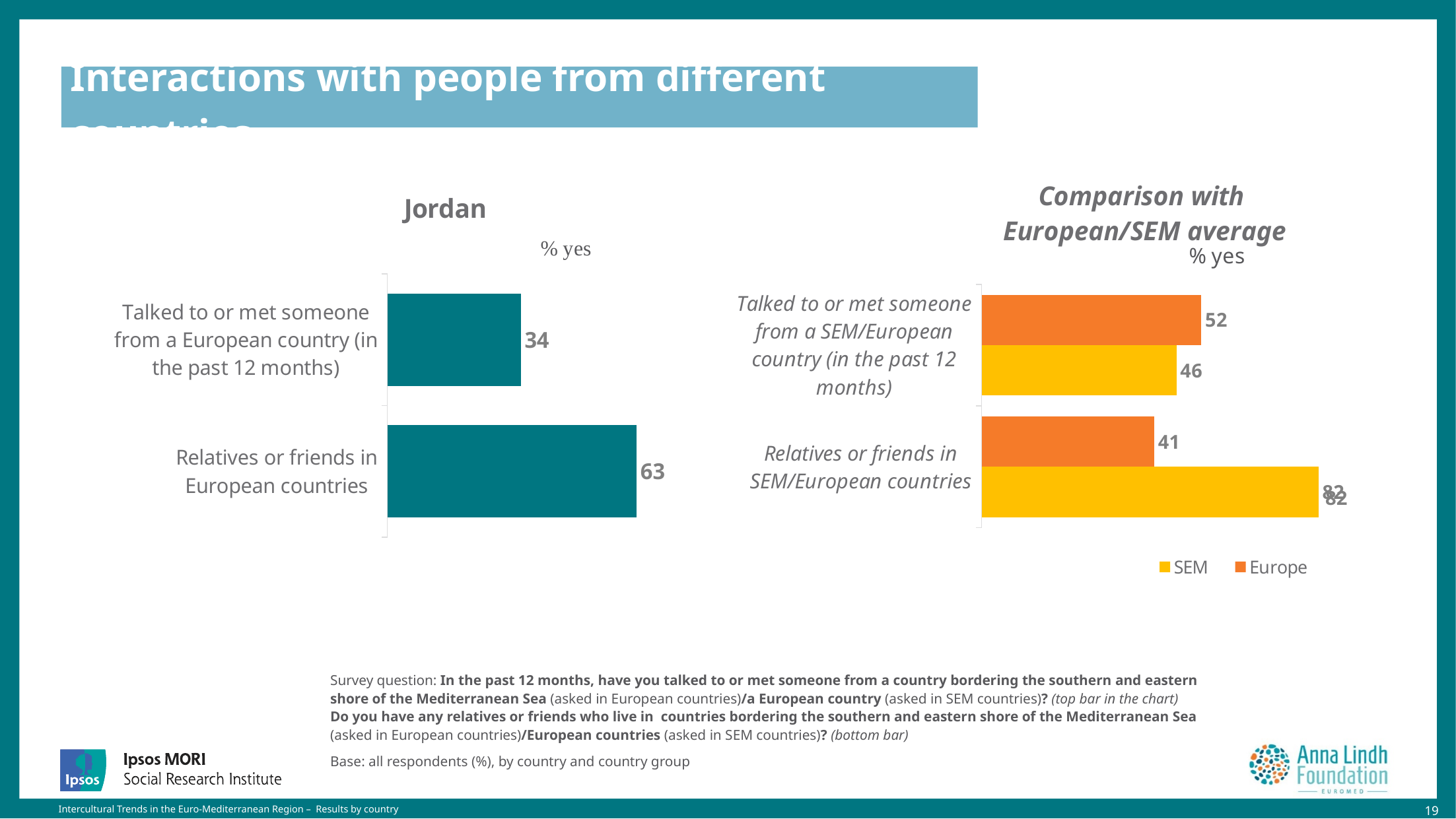
What kind of chart is the Jordan chart? Bar chart In the 'Comparison with European/SEM average' chart, what is the Europe value for 'Relatives or friends in SEM/European countries'? 41 In the 'Comparison with European/SEM average' chart, what is the difference between the Europe and SEM values for 'Talked to or met someone from a SEM/European country'? 6 In the Jordan chart, what is the value for 'Relatives or friends in European countries'? 63 How many series does the legend of the 'Comparison with European/SEM average' chart list? 2 In the Jordan chart, how many categories are plotted? 2 In the Jordan chart, what is the value for 'Talked to or met someone from a European country (in the past 12 months)'? 34 In the 'Comparison with European/SEM average' chart, what is the Europe value for 'Talked to or met someone from a SEM/European country (in the past 12 months)'? 52 In the Jordan chart, which category has the highest value? Relatives or friends in European countries In the 'Comparison with European/SEM average' chart, which is larger for 'Talked to or met someone from a SEM/European country': the SEM value or the Europe value? Europe In the 'Comparison with European/SEM average' chart, what is the SEM value for 'Talked to or met someone from a SEM/European country (in the past 12 months)'? 46 In the Jordan chart, what is the difference between the value for 'Relatives or friends in European countries' and the value for 'Talked to or met someone from a European country'? 29